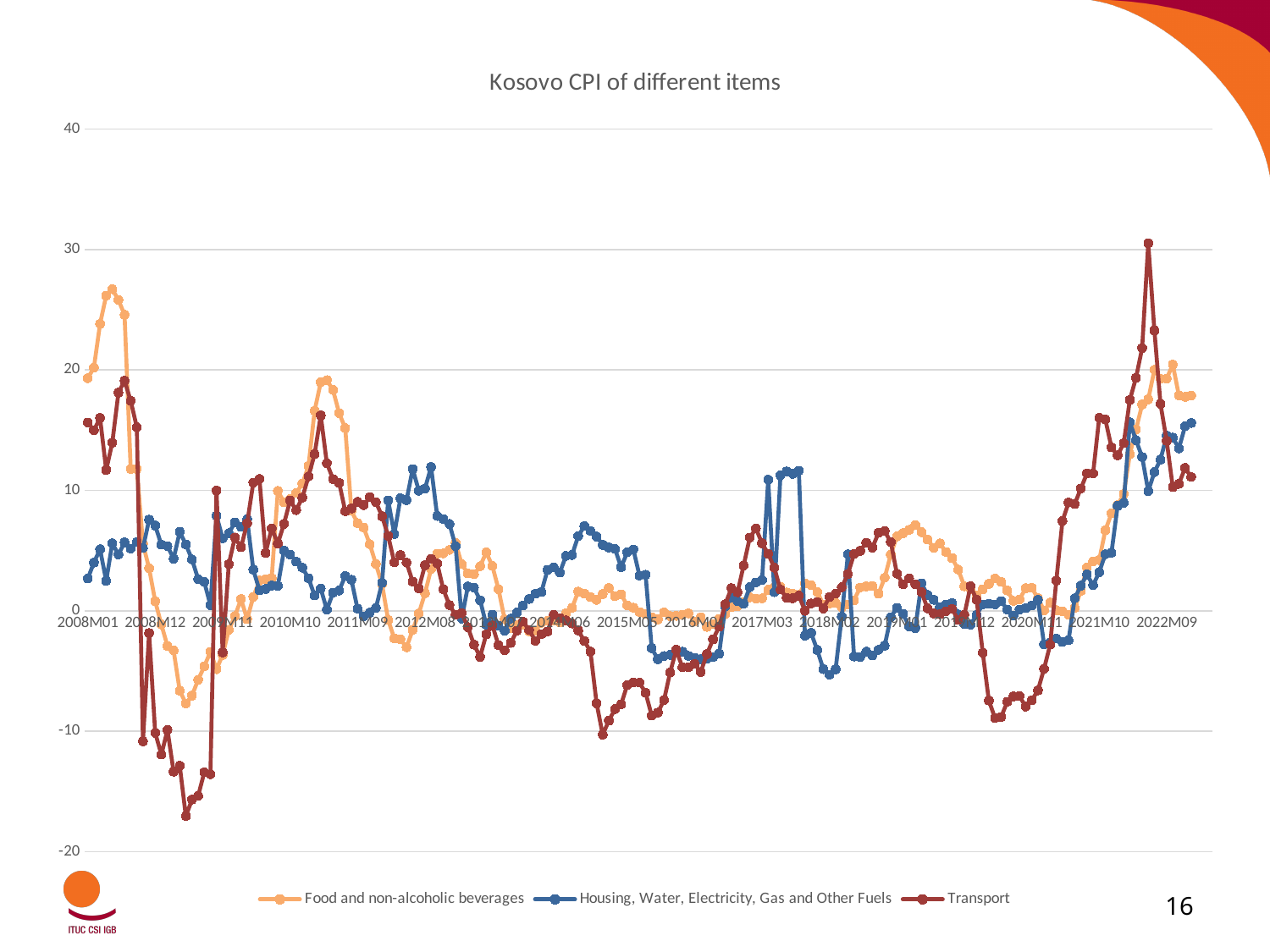
What type of chart is shown on the slide? Line chart How many series does the legend list? 3 Which is higher for the Food and non-alcoholic beverages series: its peak in 2008 or its peak in 2022? Its peak in 2008 Which series reaches the highest value anywhere on the chart? Transport Does the Food and non-alcoholic beverages series rise or fall between 2021M10 and 2022M09? Rise Is the value of the Housing, Water, Electricity, Gas and Other Fuels series at 2022M09 greater or less than 10? greater Is the peak value of the Food and non-alcoholic beverages series in 2008 greater or less than 20? greater What colour is the Transport line? Dark red Is the lowest value of the Transport series around 2009 greater or less than -10? less What is the title of the chart? Kosovo CPI of different items Which series reaches the lowest value anywhere on the chart? Transport